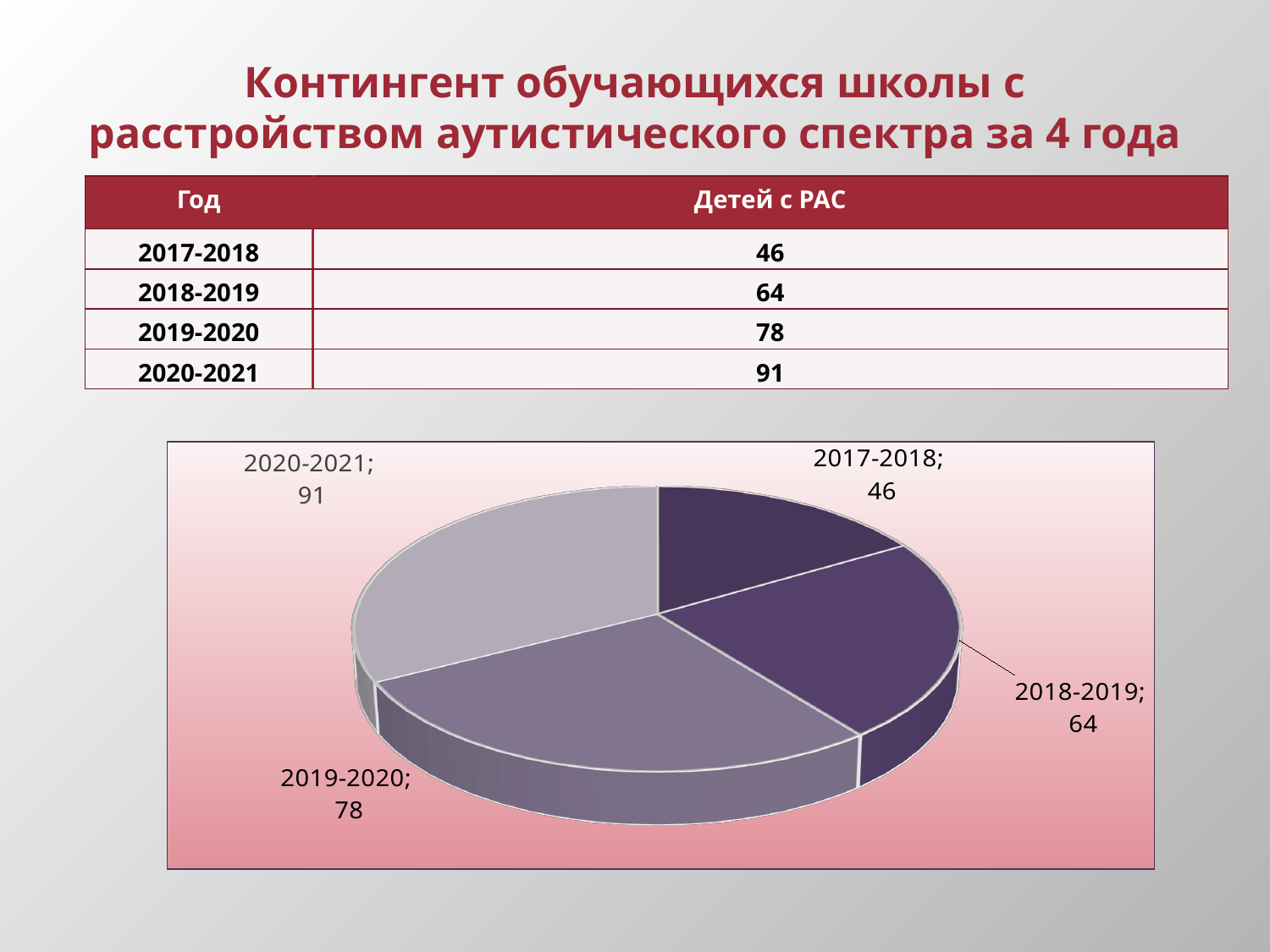
Which year has the smallest slice in the pie chart? 2017-2018 What is the total of all four values shown in the pie chart? 279 What is the value for 2020-2021 in the pie chart? 91 What is the value for 2017-2018 in the pie chart? 46 Which is larger in the pie chart, the value for 2018-2019 or the value for 2019-2020? 2019-2020 What type of chart is shown on the slide? pie chart Which year has the largest slice in the pie chart? 2020-2021 How many slices does the pie chart have? 4 Do the values in the pie chart rise or fall from 2017-2018 to 2020-2021? rise What is the value for 2018-2019 in the pie chart? 64 What is the difference between the values for 2020-2021 and 2017-2018 in the pie chart? 45 What is the value for 2019-2020 in the pie chart? 78